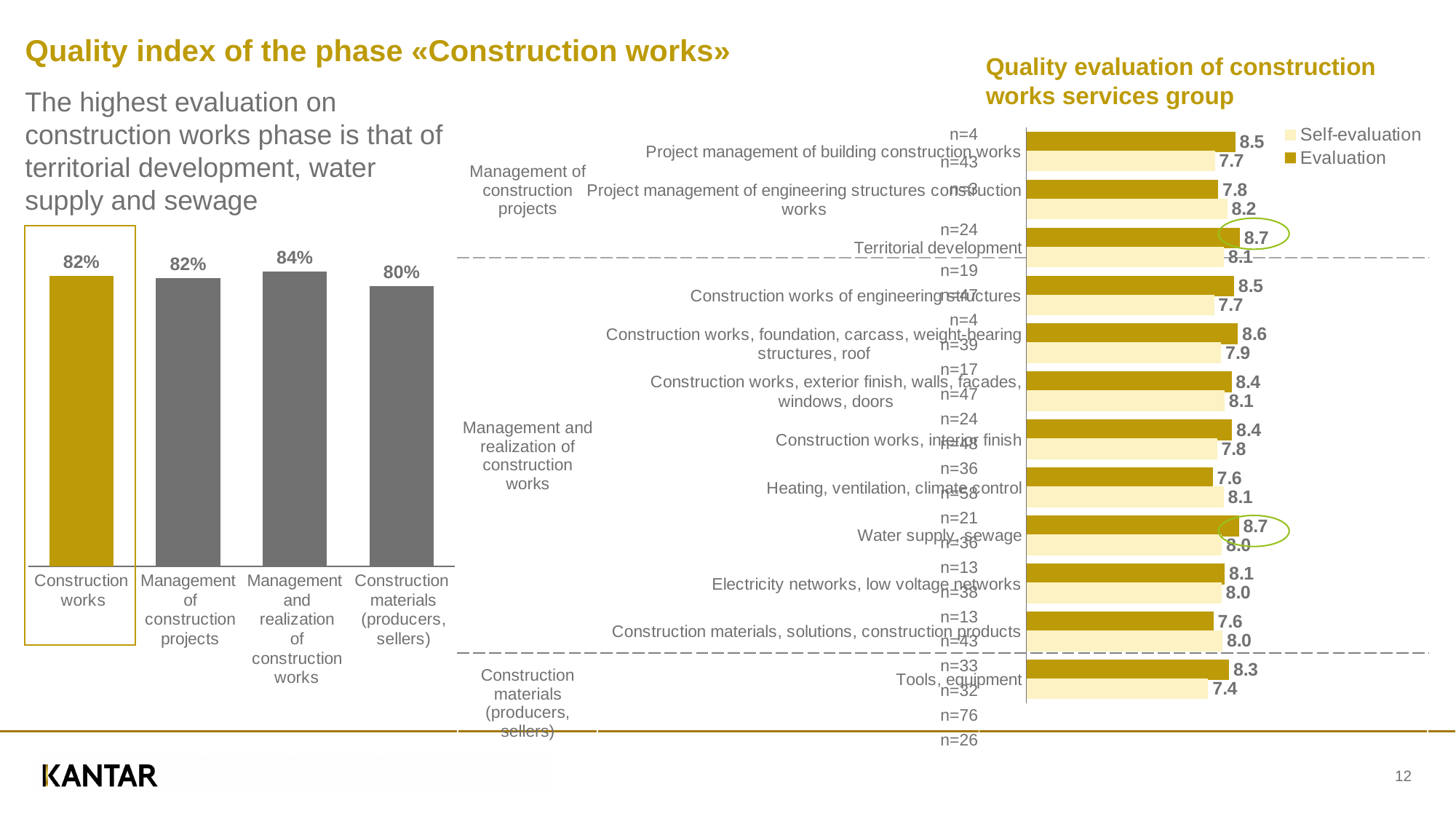
In the left chart, what is the difference between Management and realization of construction works and Construction materials (producers, sellers)? 4 percentage points What type of chart is the left chart? Bar chart In the chart 'Quality evaluation of construction works services group', what is the Self-evaluation value for Tools, equipment? 7.4 In the left chart, which category has the highest value? Management and realization of construction works In the left chart, which category has the lowest value? Construction materials (producers, sellers) In the chart 'Quality evaluation of construction works services group', what is the Evaluation value for Territorial development? 8.7 In the chart 'Quality evaluation of construction works services group', what is the difference between the Evaluation and Self-evaluation values for Tools, equipment? 0.9 In the left chart, what is the value for Management and realization of construction works? 84% In the chart 'Quality evaluation of construction works services group', what is the Evaluation value for Water supply, sewage? 8.7 In the chart 'Quality evaluation of construction works services group', how many series does the legend list? 2 How many categories are shown in the left chart? 4 In the chart 'Quality evaluation of construction works services group', which is larger for Heating, ventilation, climate control: Evaluation or Self-evaluation? Self-evaluation